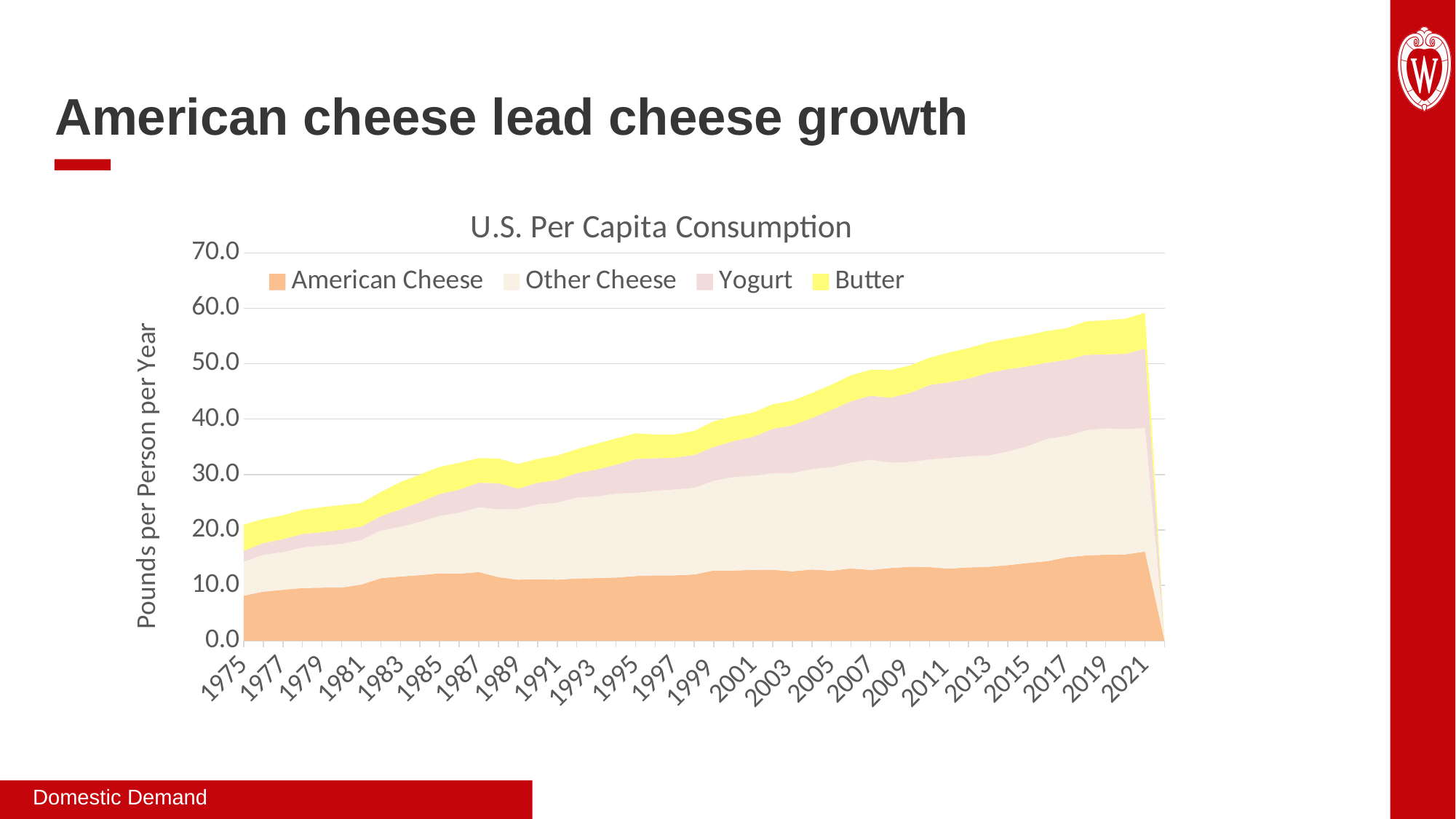
Is the total stacked value in 2021 greater or less than 50? greater Is the value for American Cheese in 2021 greater or less than 10? greater What kind of chart is shown on the slide? Stacked area chart Is the total stacked value in 1975 greater or less than 30? less What is the label on the vertical axis of the chart? Pounds per Person per Year What is the title of the chart? U.S. Per Capita Consumption How many series does the legend list? 4 Does the American Cheese series generally rise or fall from 1975 to 2021? rise Does the total per capita consumption generally rise or fall from 1975 to 2021? rise How many year labels are shown on the x axis? 24 In 2021, which is larger: the Other Cheese band or the Butter band? Other Cheese